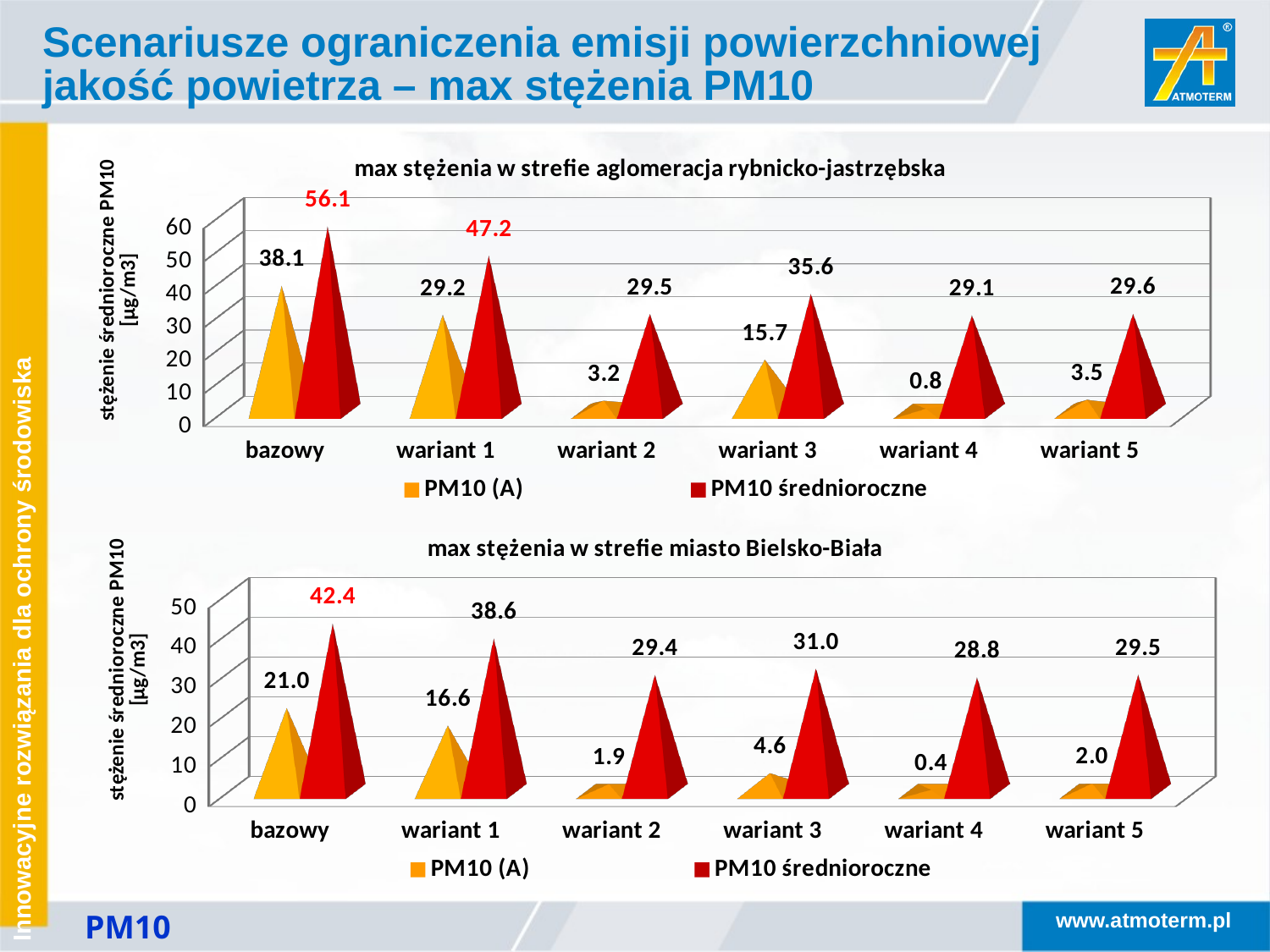
In the chart 'max stężenia w strefie miasto Bielsko-Biała', what is the difference between the PM10 (A) values for bazowy and wariant 1? 4.4 In the chart 'max stężenia w strefie aglomeracja rybnicko-jastrzębska', which category has the lowest PM10 (A) value? wariant 4 In the chart 'max stężenia w strefie aglomeracja rybnicko-jastrzębska', what is the PM10 (A) value for wariant 3? 15.7 In the chart 'max stężenia w strefie aglomeracja rybnicko-jastrzębska', what is the PM10 średnioroczne value for bazowy? 56.1 In the chart 'max stężenia w strefie miasto Bielsko-Biała', what is the PM10 średnioroczne value for bazowy? 42.4 In the chart 'max stężenia w strefie miasto Bielsko-Biała', how many categories are shown on the x axis? 6 In the chart 'max stężenia w strefie miasto Bielsko-Biała', which category has the highest PM10 średnioroczne value? bazowy In the chart 'max stężenia w strefie miasto Bielsko-Biała', which is larger: the PM10 średnioroczne value for wariant 3 or for wariant 5? wariant 3 In the chart 'max stężenia w strefie aglomeracja rybnicko-jastrzębska', what is the difference between the PM10 średnioroczne values for bazowy and wariant 1? 8.9 What is the y-axis label of the chart 'max stężenia w strefie aglomeracja rybnicko-jastrzębska'? stężenie średnioroczne PM10 [µg/m3] In the chart 'max stężenia w strefie miasto Bielsko-Biała', what is the PM10 (A) value for wariant 4? 0.4 In the chart 'max stężenia w strefie aglomeracja rybnicko-jastrzębska', how many series does the legend list? 2